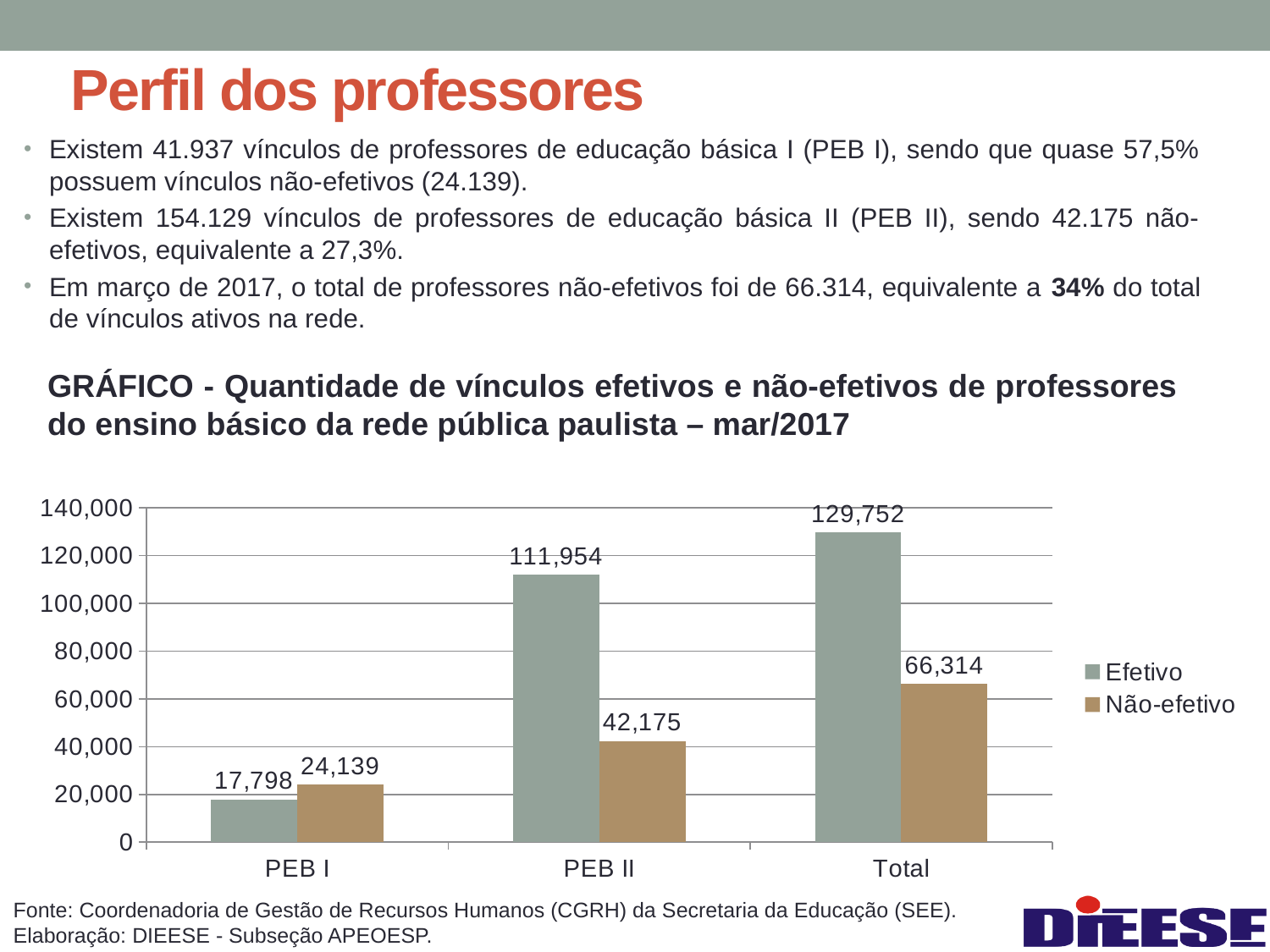
What is the Efetivo value for PEB II? 111,954 What is the difference between the Efetivo and Não-efetivo values for PEB II? 69,779 Which category has the lowest Não-efetivo value? PEB I How many series does the legend list? 2 What is the Não-efetivo value for PEB I? 24,139 What are the two series named in the legend? Efetivo and Não-efetivo What is the Não-efetivo value for Total? 66,314 How many categories are shown on the x axis? 3 What kind of chart is shown on the slide? bar chart For PEB I, which is larger: Efetivo or Não-efetivo? Não-efetivo Which category has the highest Efetivo value? Total Is the Efetivo value for Total greater or less than 120,000? greater